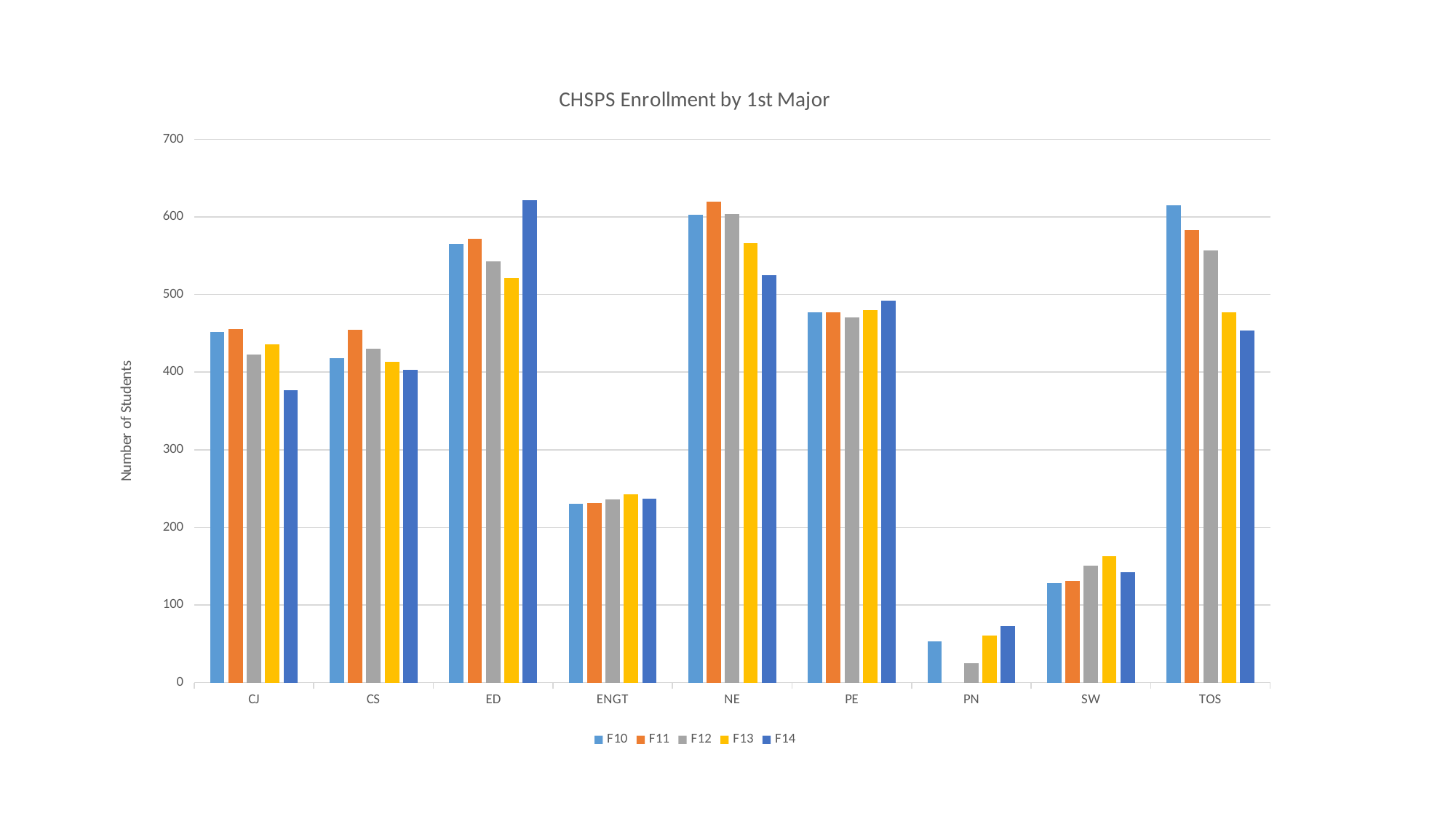
Which major has the lowest F10 enrollment? PN Which is larger, the F11 value for NE or the F11 value for TOS? NE How many majors (categories) are shown on the x axis? 9 How many series does the legend list? 5 Which major has the lowest F14 enrollment? PN Do the TOS values rise or fall from F10 to F14? fall Which major has the highest F14 enrollment? ED Is the F13 value for SW greater or less than 200? less Is the F10 value for TOS greater or less than 600? greater Is the F14 value for CJ greater or less than 400? less What is the label on the vertical axis? Number of Students What kind of chart is shown on the slide? bar chart